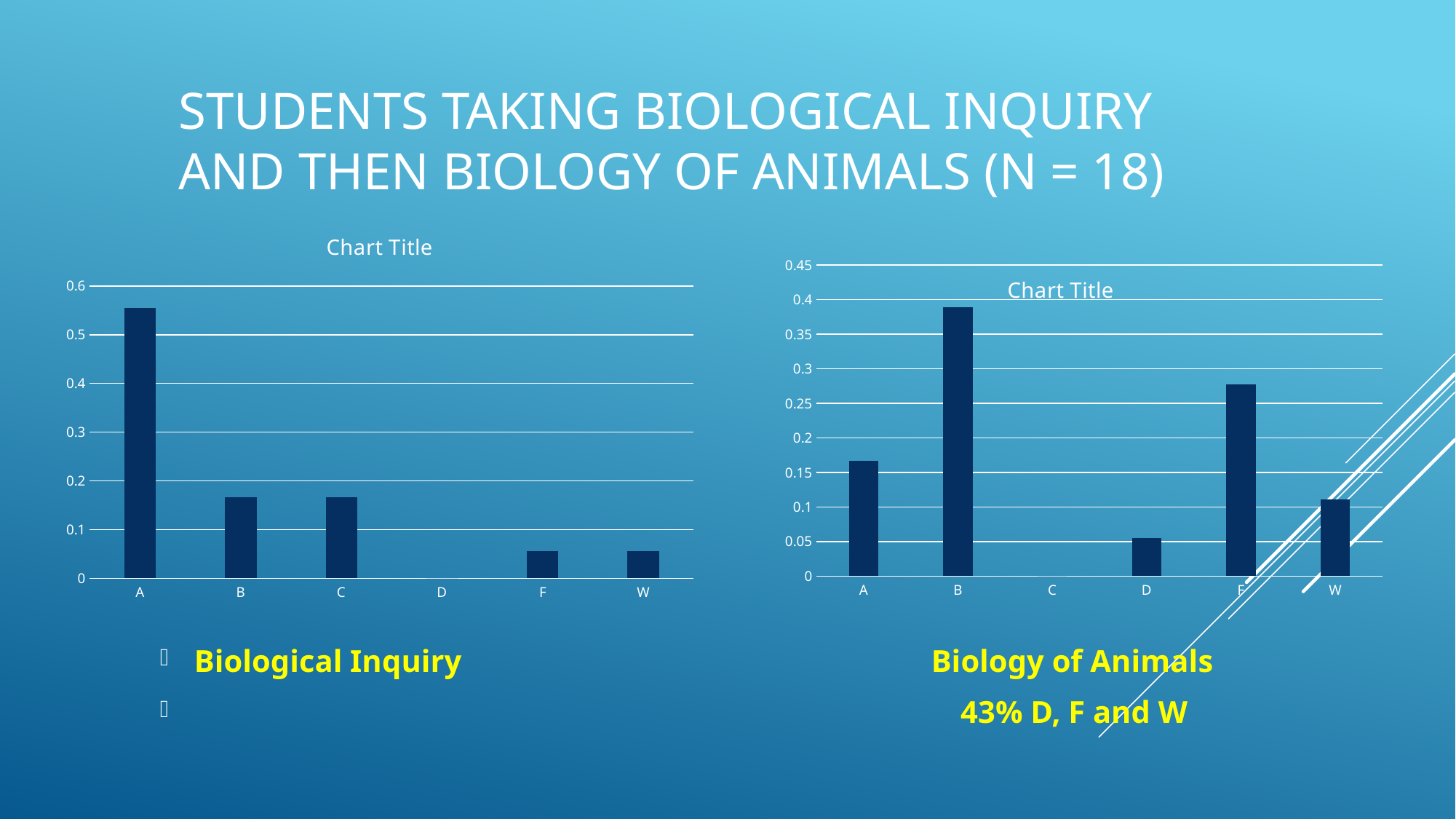
How many categories are shown on the x axis of the right chart (Biology of Animals)? 6 What is the title printed above the left chart? Chart Title In the right chart (Biology of Animals), is the value for F greater or less than 0.25? greater In the left chart (Biological Inquiry), is the value for A greater or less than 0.5? greater In the left chart (Biological Inquiry), which category has the highest value? A In the right chart (Biology of Animals), which category has the lowest value? C In the right chart (Biology of Animals), which category has the highest value? B In the left chart (Biological Inquiry), which category has the lowest value? D In the right chart (Biology of Animals), is the value for W greater or less than 0.15? less In the left chart (Biological Inquiry), which is larger, the value for B or the value for F? B In the right chart (Biology of Animals), which is larger, the value for A or the value for B? B What kind of chart is the left chart (Biological Inquiry)? bar chart